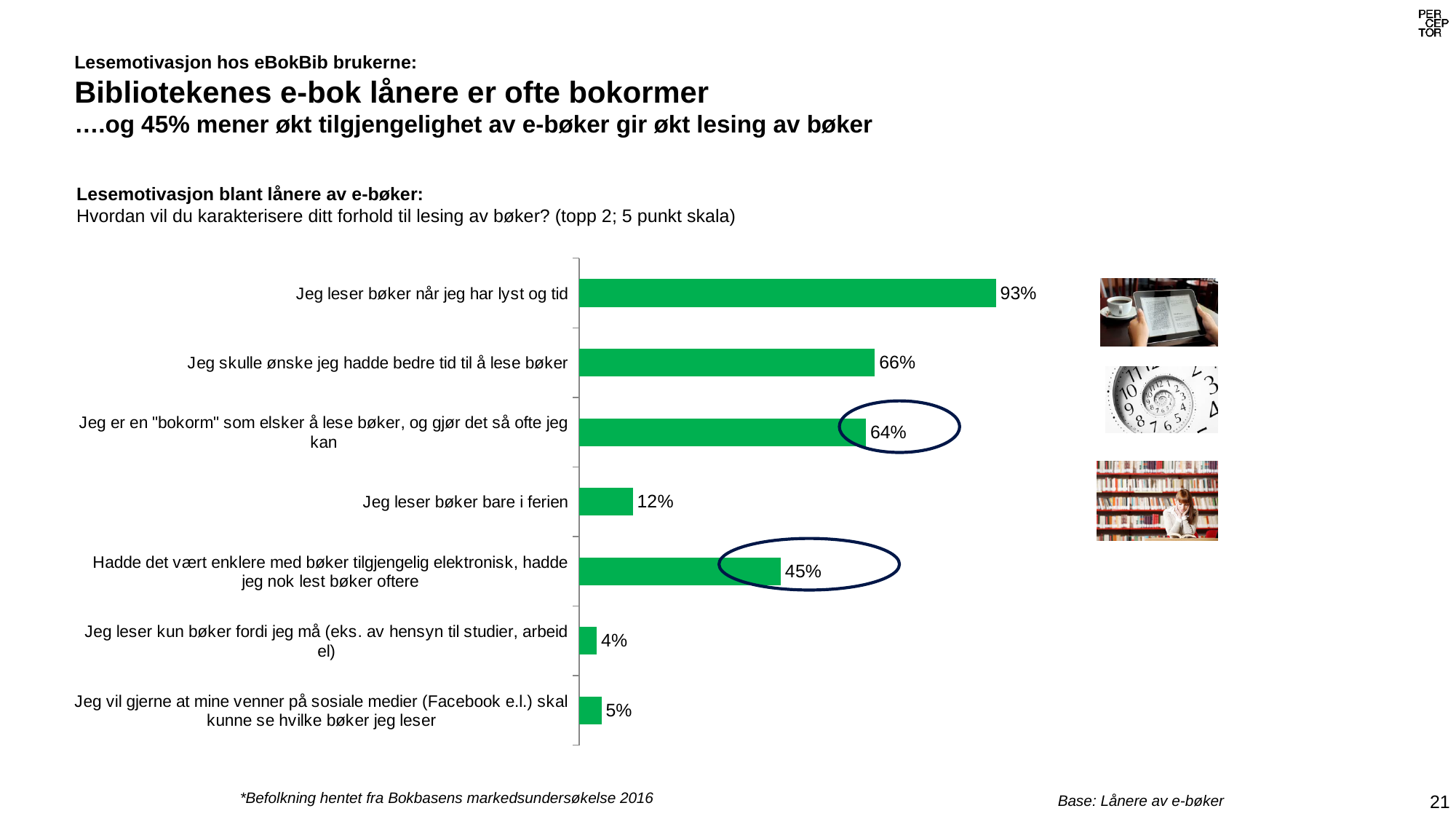
What is the value for "Jeg leser bøker bare i ferien"? 12% What kind of chart is shown on the slide? Bar chart How many categories are shown in the chart? 7 Which category has the lowest value? Jeg leser kun bøker fordi jeg må (eks. av hensyn til studier, arbeid el) Which is larger: the value for "Jeg leser bøker bare i ferien" or the value for "Jeg vil gjerne at mine venner på sosiale medier (Facebook e.l.) skal kunne se hvilke bøker jeg leser"? Jeg leser bøker bare i ferien What is the value for "Jeg skulle ønske jeg hadde bedre tid til å lese bøker"? 66% Which category has the highest value? Jeg leser bøker når jeg har lyst og tid What is the difference between the values for "Jeg leser bøker når jeg har lyst og tid" and "Jeg skulle ønske jeg hadde bedre tid til å lese bøker"? 27% What is the value for "Jeg leser bøker når jeg har lyst og tid"? 93% What is the difference between the values for "Jeg er en "bokorm" som elsker å lese bøker, og gjør det så ofte jeg kan" and "Hadde det vært enklere med bøker tilgjengelig elektronisk, hadde jeg nok lest bøker oftere"? 19% What is the value for "Jeg leser kun bøker fordi jeg må (eks. av hensyn til studier, arbeid el)"? 4% Which two values in the chart are circled? 64% and 45%